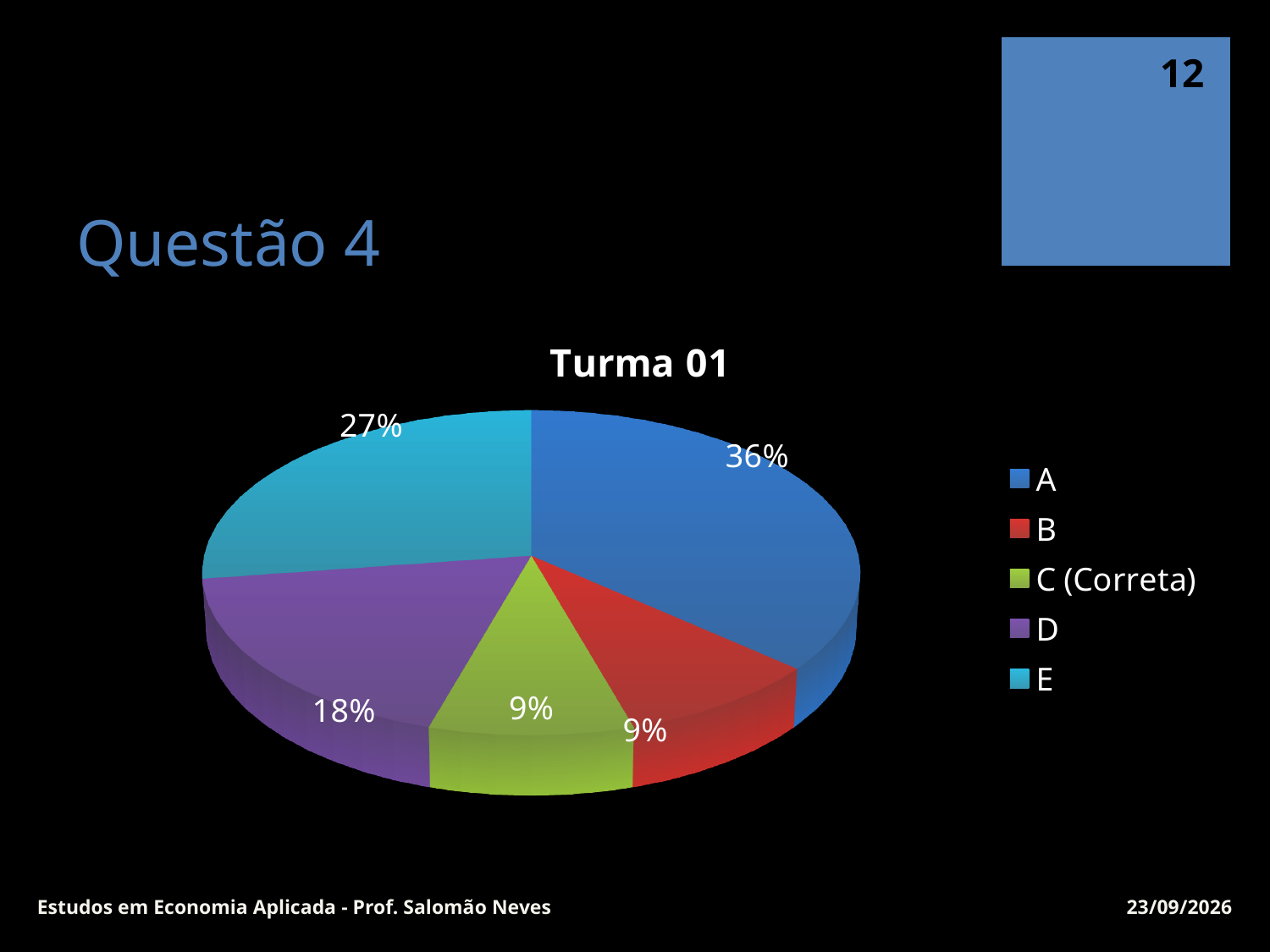
What is the difference between the share of slice A and the share of slice E? 9% What percentage of the pie does slice C (Correta) represent? 9% What percentage of the pie does slice A represent? 36% What percentage of the pie does slice D represent? 18% Which legend entry is marked as the correct answer? C (Correta) Which is larger, the share of slice D or the share of slice B? D How many entries does the legend list? 5 What percentage of the pie does slice E represent? 27% What is the title of the chart? Turma 01 Which slice has the largest share of the pie? A How many slices does the pie chart have? 5 What kind of chart is shown on the slide? pie chart